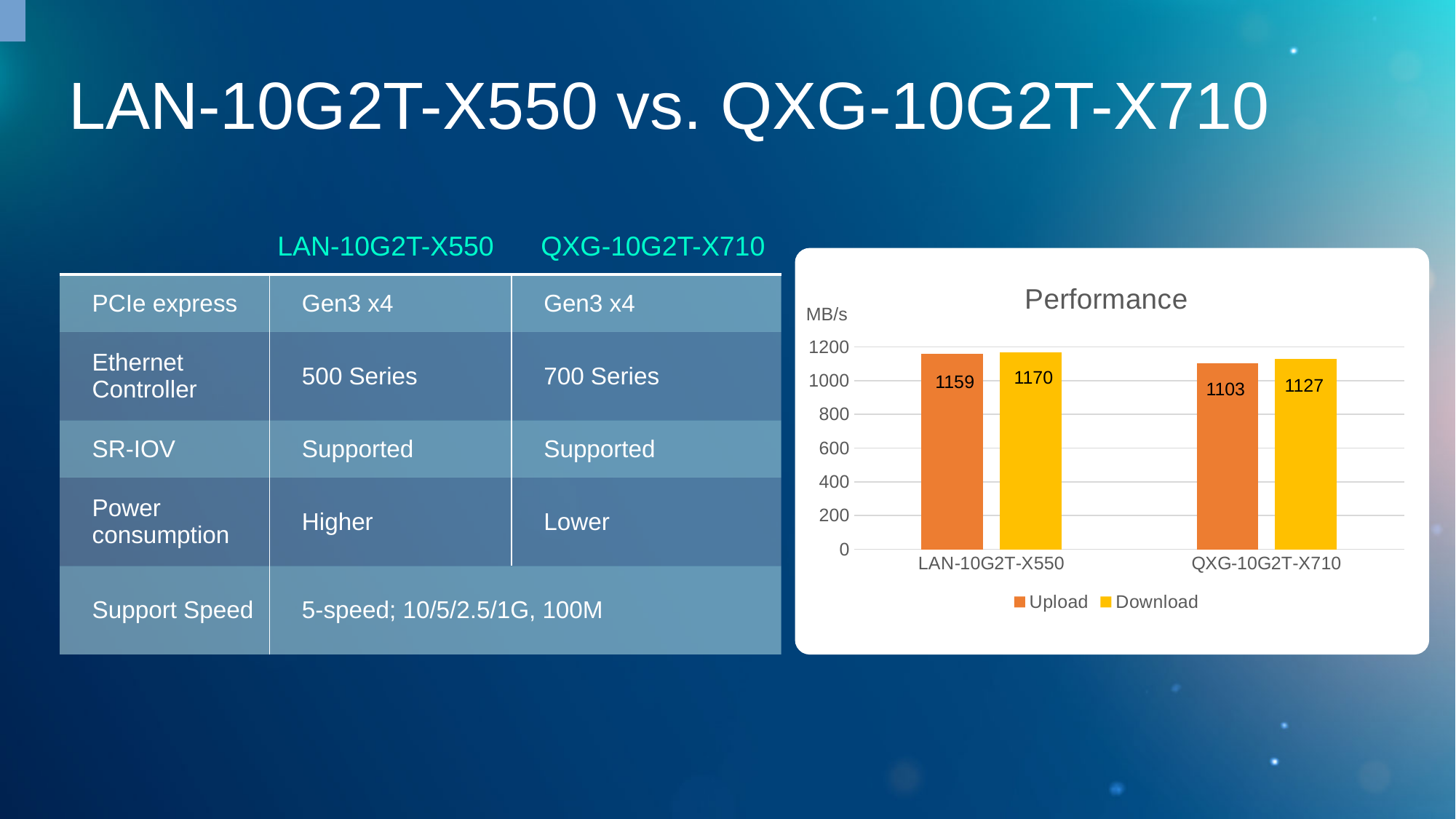
Is the Upload value for LAN-10G2T-X550 larger or smaller than the Upload value for QXG-10G2T-X710? larger What is the difference between the Upload and Download values for QXG-10G2T-X710? 24 What kind of chart is the Performance chart? bar chart What is the difference between the Download values of LAN-10G2T-X550 and QXG-10G2T-X710? 43 How many series does the legend of the Performance chart list? 2 What is the Upload value for LAN-10G2T-X550 in the Performance chart? 1159 Which category has the highest Download value in the Performance chart? LAN-10G2T-X550 What is the Upload value for QXG-10G2T-X710 in the Performance chart? 1103 What unit is shown on the y axis of the Performance chart? MB/s Which category has the lowest Upload value in the Performance chart? QXG-10G2T-X710 What is the Download value for QXG-10G2T-X710 in the Performance chart? 1127 What is the Download value for LAN-10G2T-X550 in the Performance chart? 1170